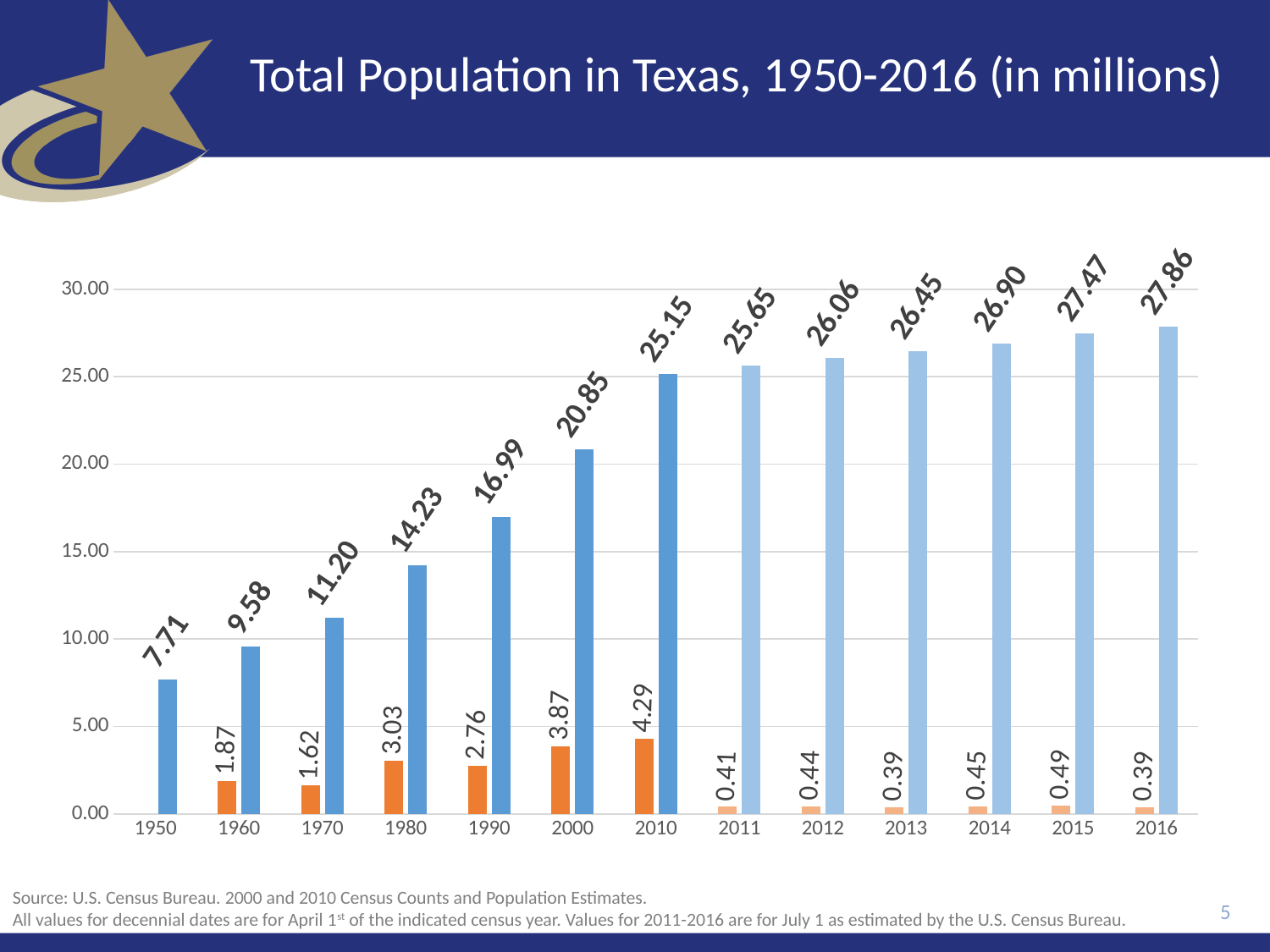
Which year has the highest total population value? 2016 What is the value of the orange bar for 2013? 0.39 How many years are shown on the x axis? 13 What is the total population value shown for 2016? 27.86 Is the total population value for 1980 greater or less than 15.00? less What is the difference between the total population values for 2010 and 2000? 4.30 Which year has the lowest total population value? 1950 What is the total population value shown for 1950? 7.71 Which is larger, the orange bar value for 2000 or for 1990? 2000 What is the value of the orange bar for 2010? 4.29 What kind of chart is shown on the slide? bar chart Do the total population values rise or fall from 1950 to 2016? rise